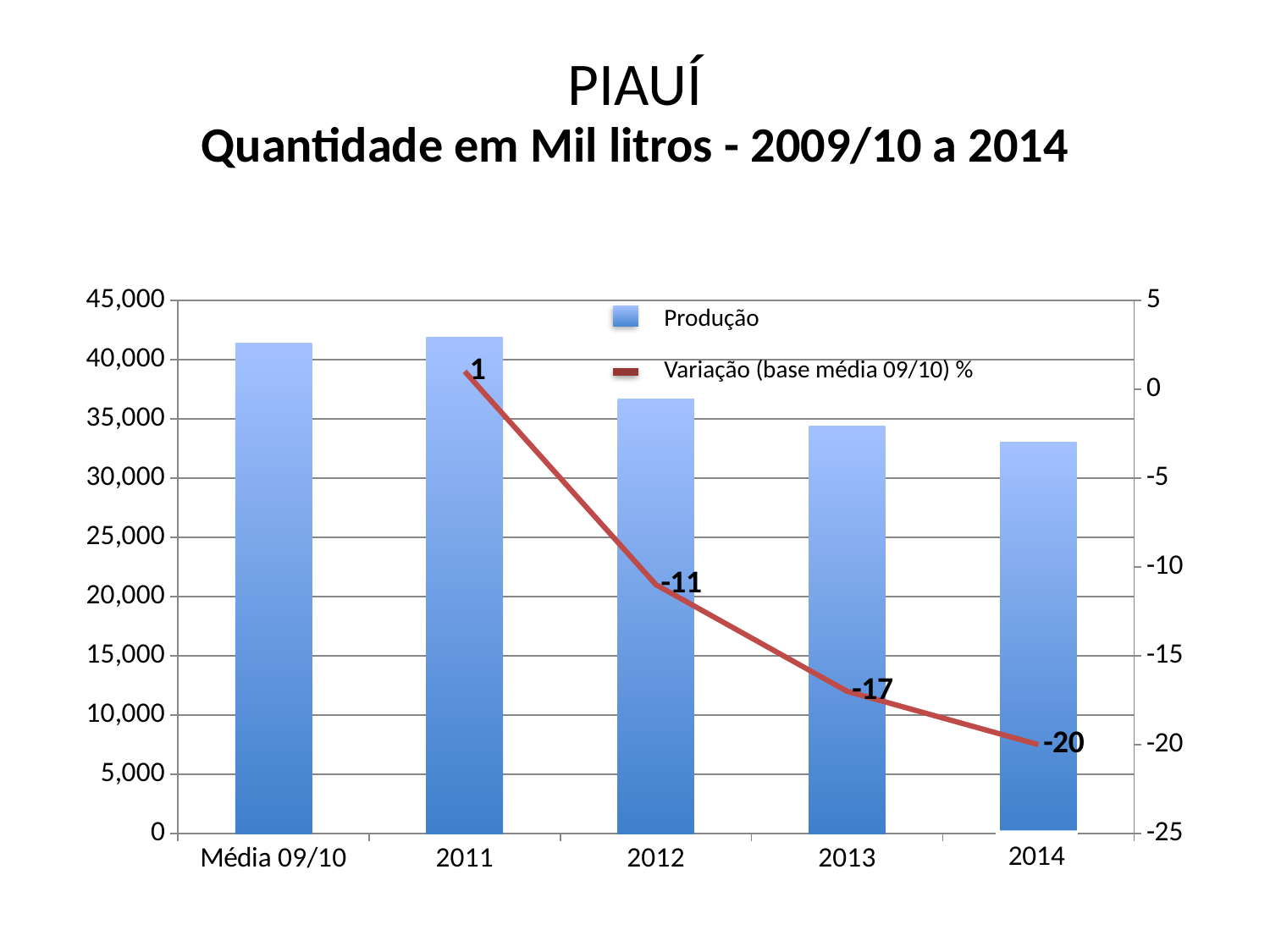
What is the difference between the Variação values for 2012 and 2013? 6 Is the Produção value for Média 09/10 greater or less than 40,000? greater Which has a higher Produção value, 2012 or 2013? 2012 Does the Variação (base média 09/10) % line rise or fall from 2011 to 2014? fall What is the value of Variação (base média 09/10) % for 2011? 1 How many categories are shown on the x axis? 5 What is the difference between the Variação values for 2011 and 2014? 21 Which year has the lowest Variação (base média 09/10) % value? 2014 What is the value of Variação (base média 09/10) % for 2012? -11 How many series does the legend list? 2 What is the value of Variação (base média 09/10) % for 2014? -20 Is the Produção value for 2014 greater or less than 35,000? less